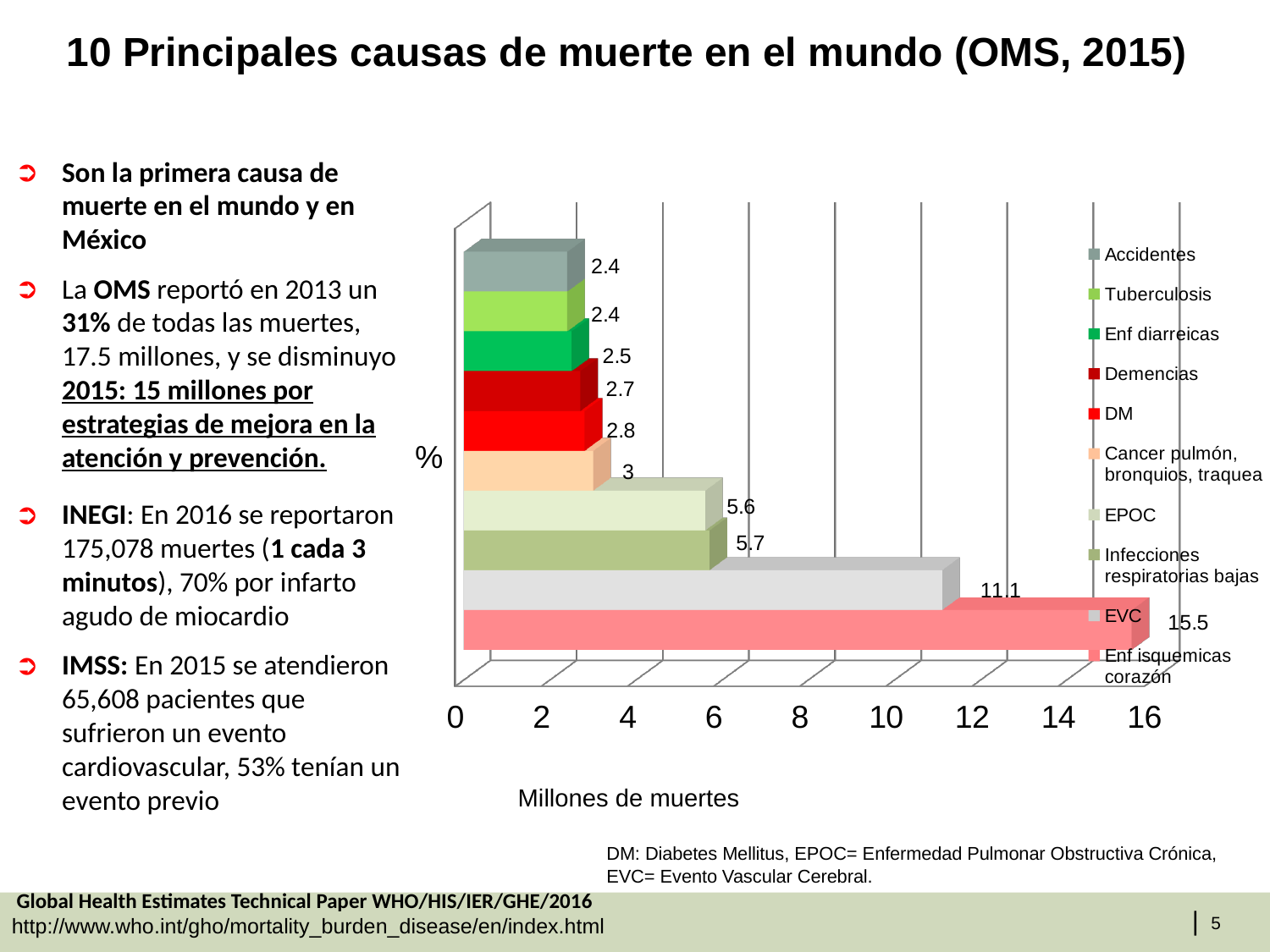
How many series does the chart legend list? 10 What is the difference between the values for Infecciones respiratorias bajas and EPOC? 0.1 Is the value for Cancer pulmón, bronquios, traquea greater or less than 4? less Which is larger, the value for EVC or the value for Infecciones respiratorias bajas? EVC What is the value for EPOC? 5.6 Which cause of death has the highest value in the chart? Enf isquemicas corazón What is the value for EVC? 11.1 What is the value for Enf isquemicas corazón? 15.5 What is the difference between the values for Enf isquemicas corazón and EVC? 4.4 What is the label on the horizontal axis of the chart? Millones de muertes What kind of chart is shown on the slide? bar chart What is the value for DM? 2.8